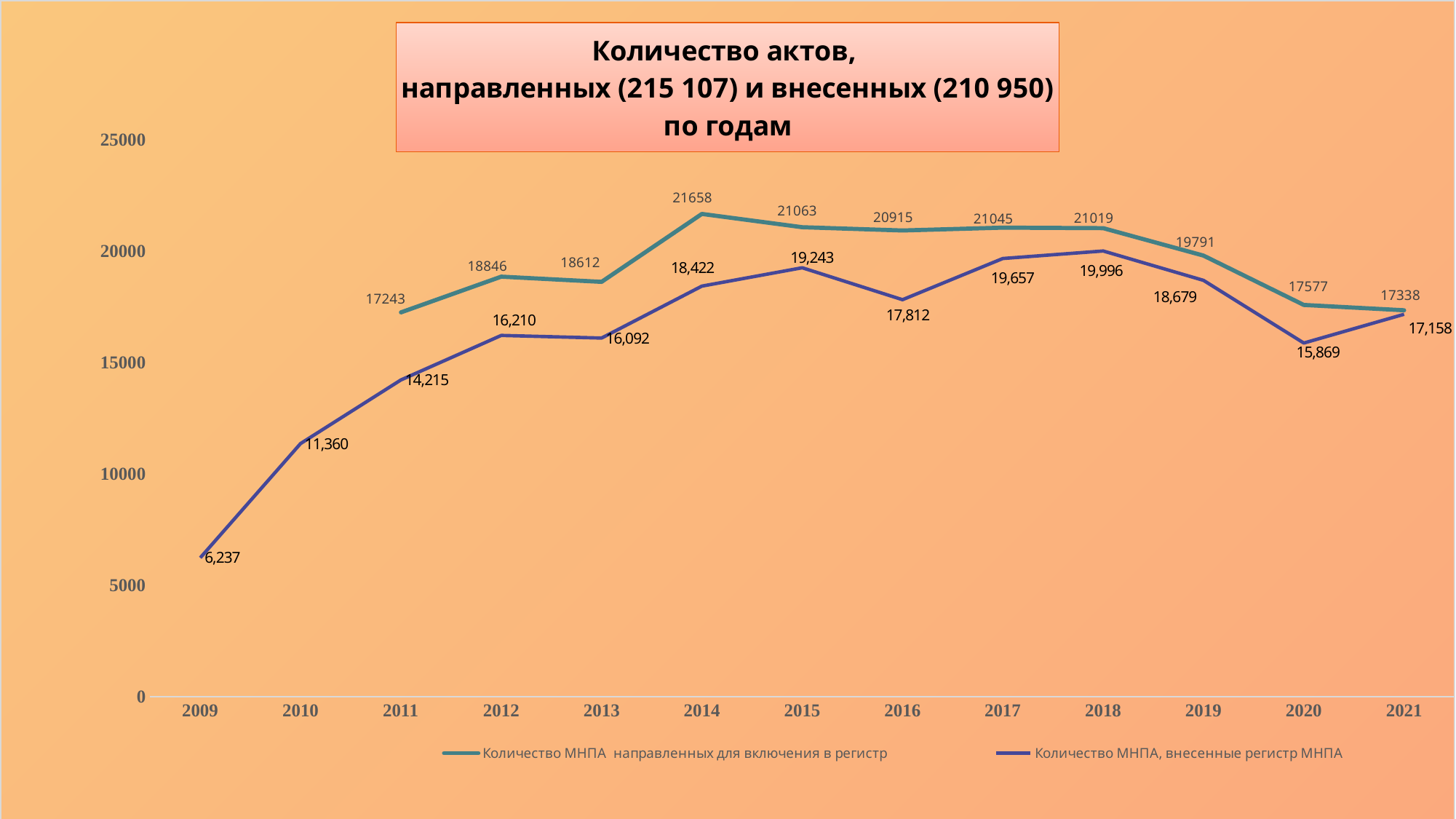
Which series has the larger value in 2016? Количество МНПА направленных для включения в регистр How many series does the legend list? 2 Does the series "Количество МНПА, внесенные регистр МНПА" rise or fall from 2009 to 2015? Rise What is the difference between the two series' values in 2014? 3236 What is the value of the series "Количество МНПА направленных для включения в регистр" in 2014? 21658 What is the value of the series "Количество МНПА, внесенные регистр МНПА" in 2018? 19,996 What kind of chart is shown on the slide? Line chart What is the value of the series "Количество МНПА, внесенные регистр МНПА" in 2009? 6,237 How many years are shown on the x axis? 13 In which year does the series "Количество МНПА, внесенные регистр МНПА" have its lowest value? 2009 In which year does the series "Количество МНПА направленных для включения в регистр" reach its highest value? 2014 By how much did the series "Количество МНПА, внесенные регистр МНПА" increase from 2009 to 2010? 5,123